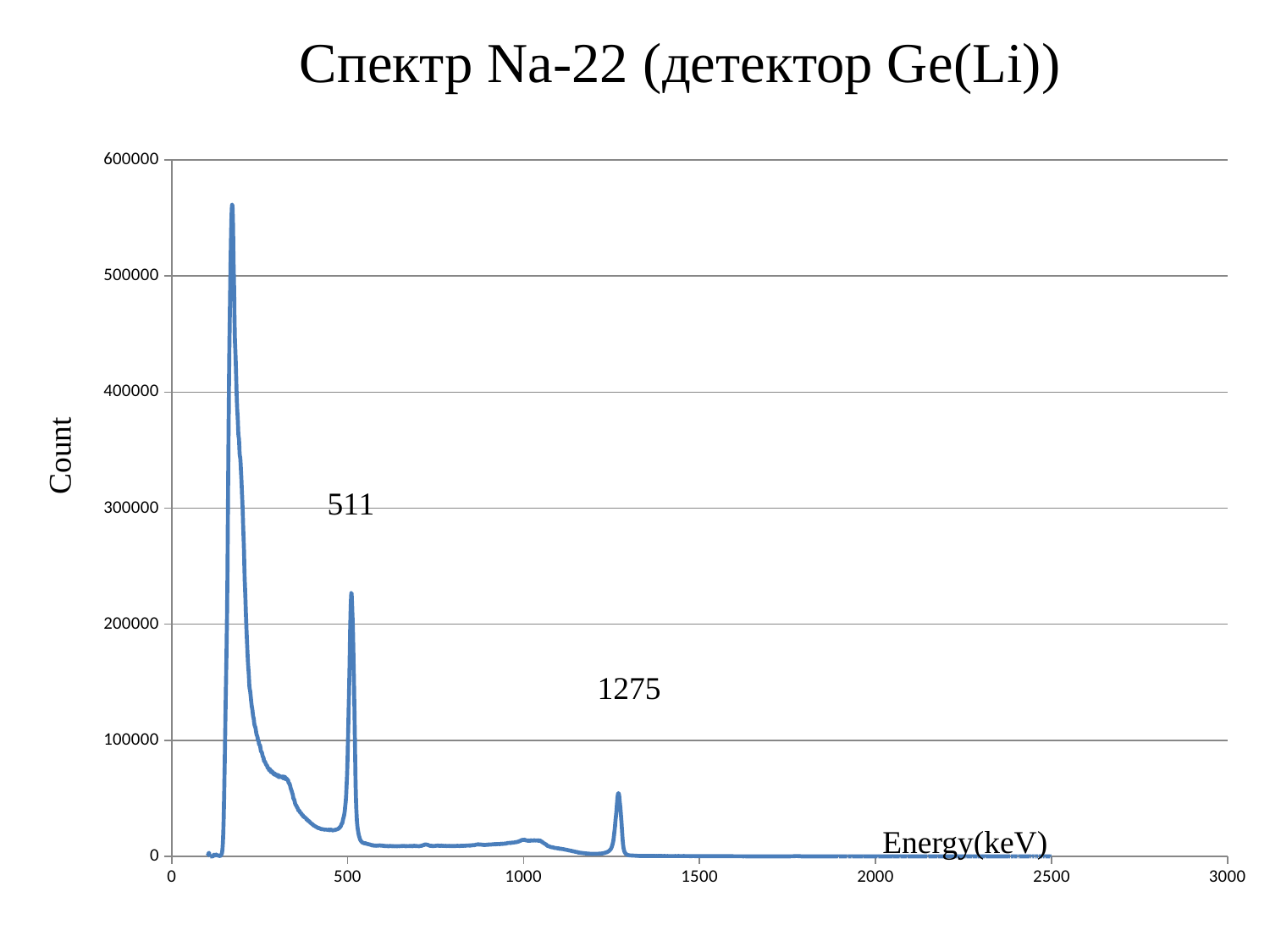
Which two energy values are annotated next to peaks on the chart? 511 and 1275 Do the counts generally rise or fall along the x axis between the peak labelled 511 and 1000 keV? fall Is the count at the tallest peak of the spectrum greater or less than 500000? greater What is the title of the chart? Спектр Na-22 (детектор Ge(Li)) What kind of chart is shown on the slide? line chart Is the count at the peak labelled 1275 greater or less than 100000? less How many data series are plotted on the chart? 1 Is the count at 2000 keV greater or less than 100000? less What is the label of the x axis? Energy(keV) What is the highest value shown on the x axis? 3000 Which peak has the higher count, the one labelled 511 or the one labelled 1275? 511